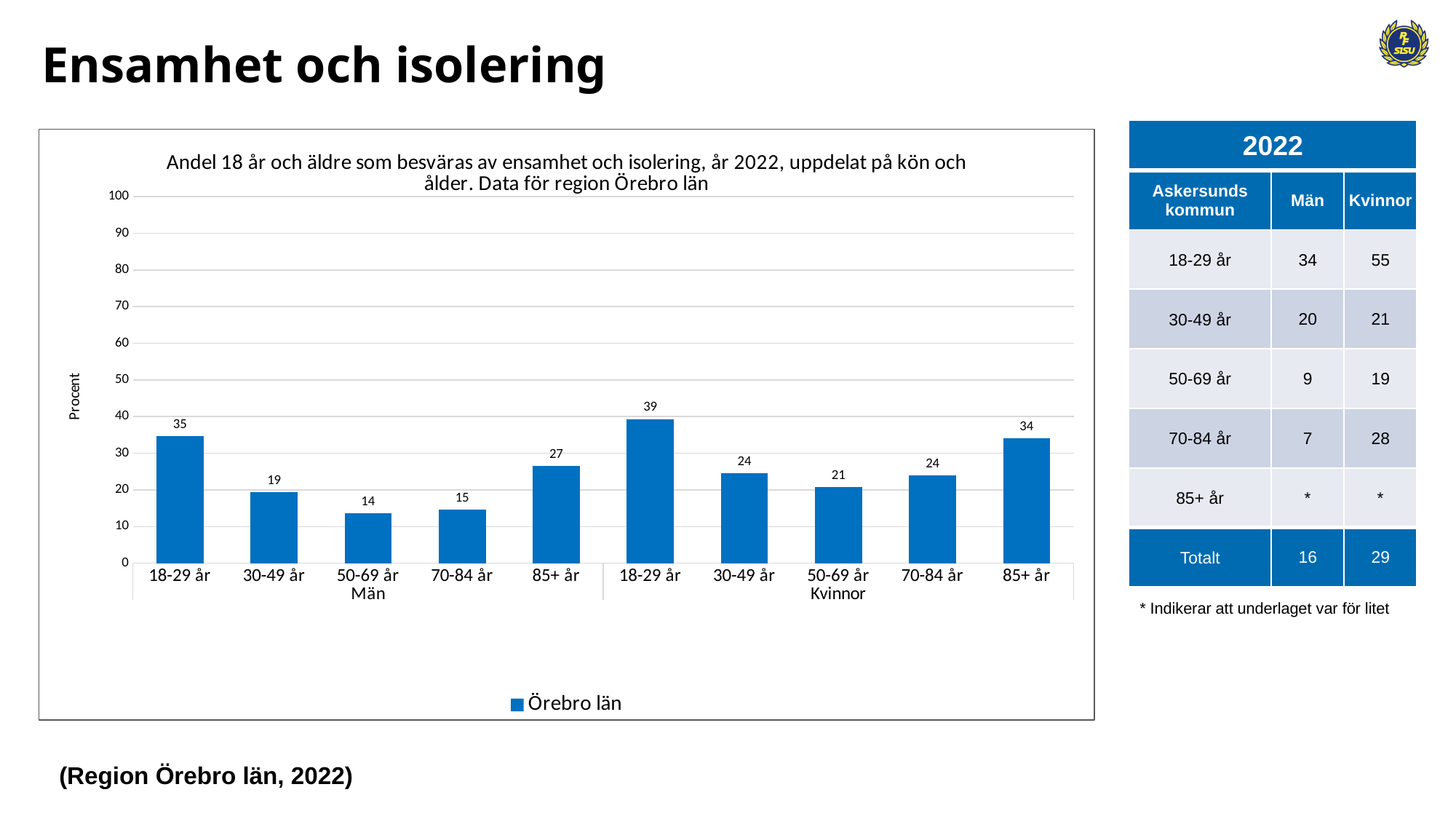
What kind of chart is shown? bar chart Which is larger, Kvinnor 85+ år or Män 85+ år? Kvinnor 85+ år What is the value for Kvinnor 50-69 år? 21 Is the value for Kvinnor 30-49 år greater or less than 20? greater What is the value for Män 85+ år? 27 How many series does the legend list? 1 What is the value for Män 18-29 år? 35 How many bars are plotted in the chart? 10 Which bar has the lowest value? Män 50-69 år What is the label of the y axis? Procent Which bar has the highest value? Kvinnor 18-29 år What is the difference between Kvinnor 18-29 år and Män 18-29 år? 4